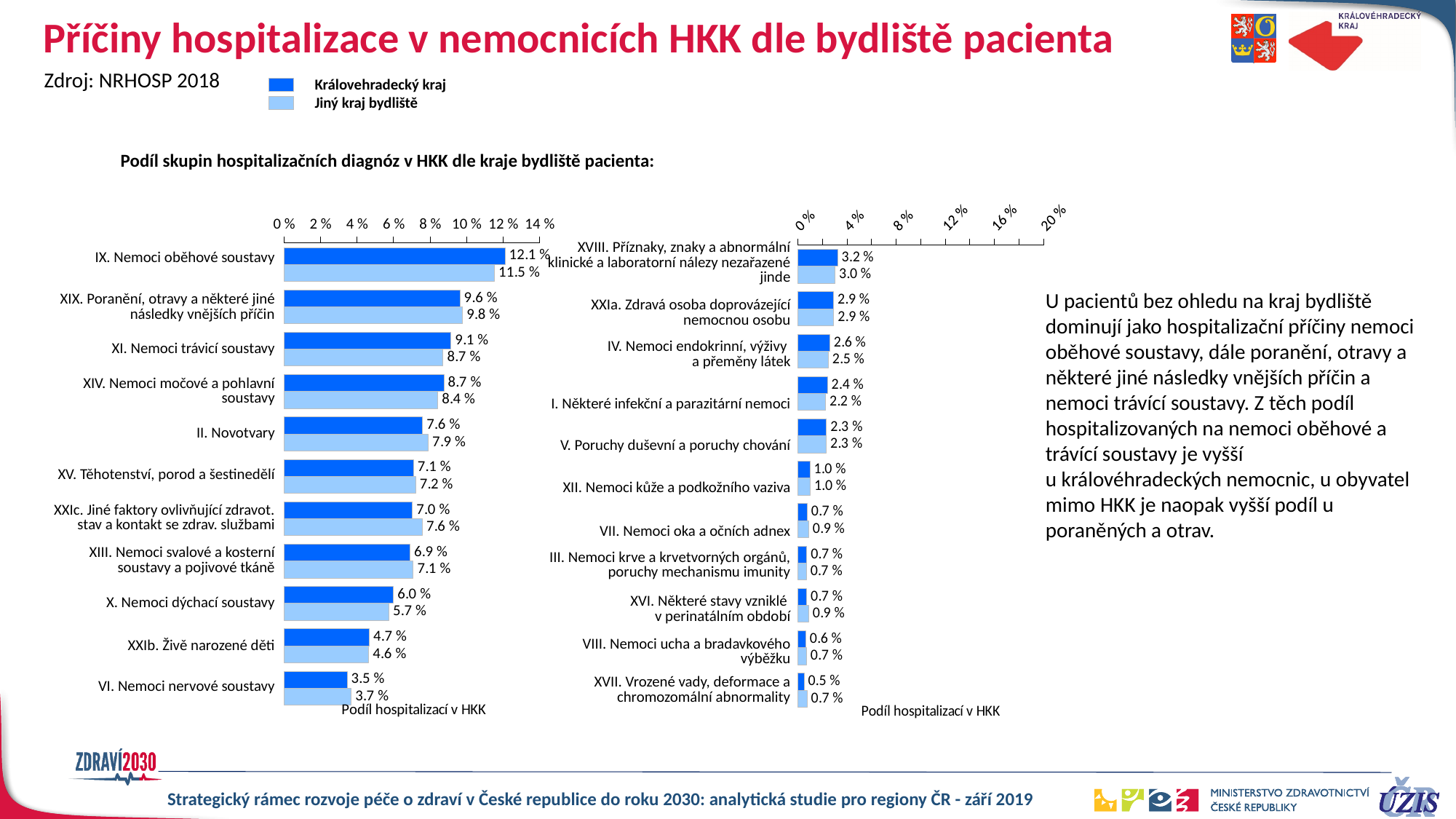
What kind of chart is the left chart? Bar chart On the right chart, how many diagnosis categories are shown? 11 On the left chart, which category has the highest value for Královehradecký kraj? IX. Nemoci oběhové soustavy On the left chart, what is the value for Královehradecký kraj for IX. Nemoci oběhové soustavy? 12.1 % On the left chart, which is larger for XXIc. Jiné faktory ovlivňující zdravot. stav a kontakt se zdrav. službami: Královehradecký kraj or Jiný kraj bydliště? Jiný kraj bydliště What is the x-axis label of the right chart? Podíl hospitalizací v HKK On the left chart, what is the difference between the Královehradecký kraj and Jiný kraj bydliště values for IX. Nemoci oběhové soustavy? 0.6 % How many series does the legend list? 2 On the left chart, which category has the lowest value for Jiný kraj bydliště? VI. Nemoci nervové soustavy On the right chart, what is the value for Královehradecký kraj for XVIII. Příznaky, znaky a abnormální klinické a laboratorní nálezy nezařazené jinde? 3.2 % On the right chart, what is the value for Jiný kraj bydliště for XVII. Vrozené vady, deformace a chromozomální abnormality? 0.7 % On the left chart, what is the value for Jiný kraj bydliště for XIX. Poranění, otravy a některé jiné následky vnějších příčin? 9.8 %